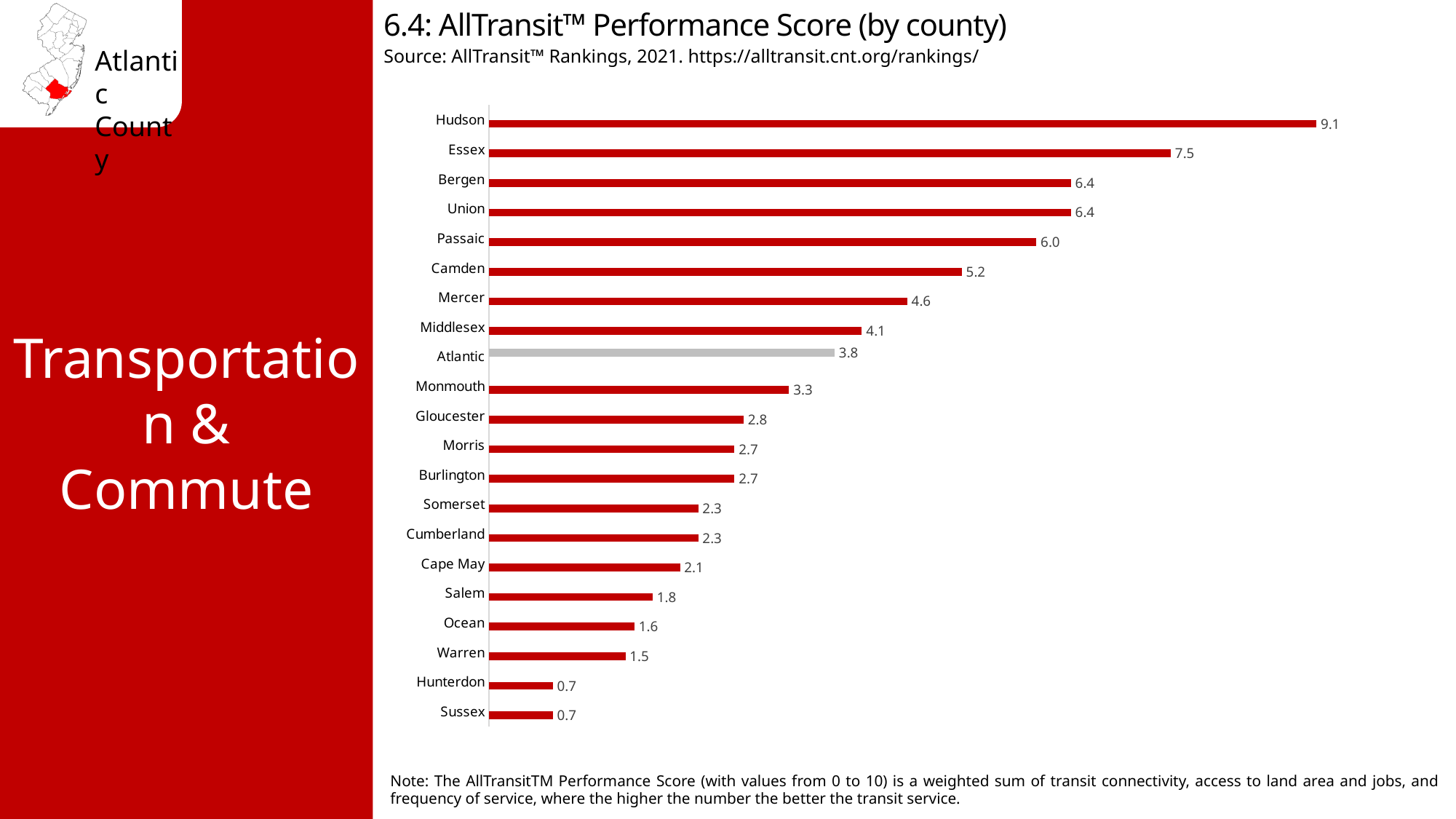
Which counties share the lowest AllTransit Performance Score? Hunterdon and Sussex Which county has the highest AllTransit Performance Score? Hudson Which has a higher AllTransit Performance Score, Mercer or Monmouth? Mercer What is the AllTransit Performance Score for Atlantic County? 3.8 What type of chart is used to show the AllTransit Performance Scores? Bar chart What is the difference between the scores of Hudson and Essex? 1.6 What is the difference between the scores of Atlantic and Middlesex? 0.3 What is the title of the chart? 6.4: AllTransit™ Performance Score (by county) Which county's bar is shown in grey instead of red? Atlantic What is the AllTransit Performance Score for Camden County? 5.2 What is the AllTransit Performance Score for Hudson County? 9.1 How many counties are shown in the chart? 21